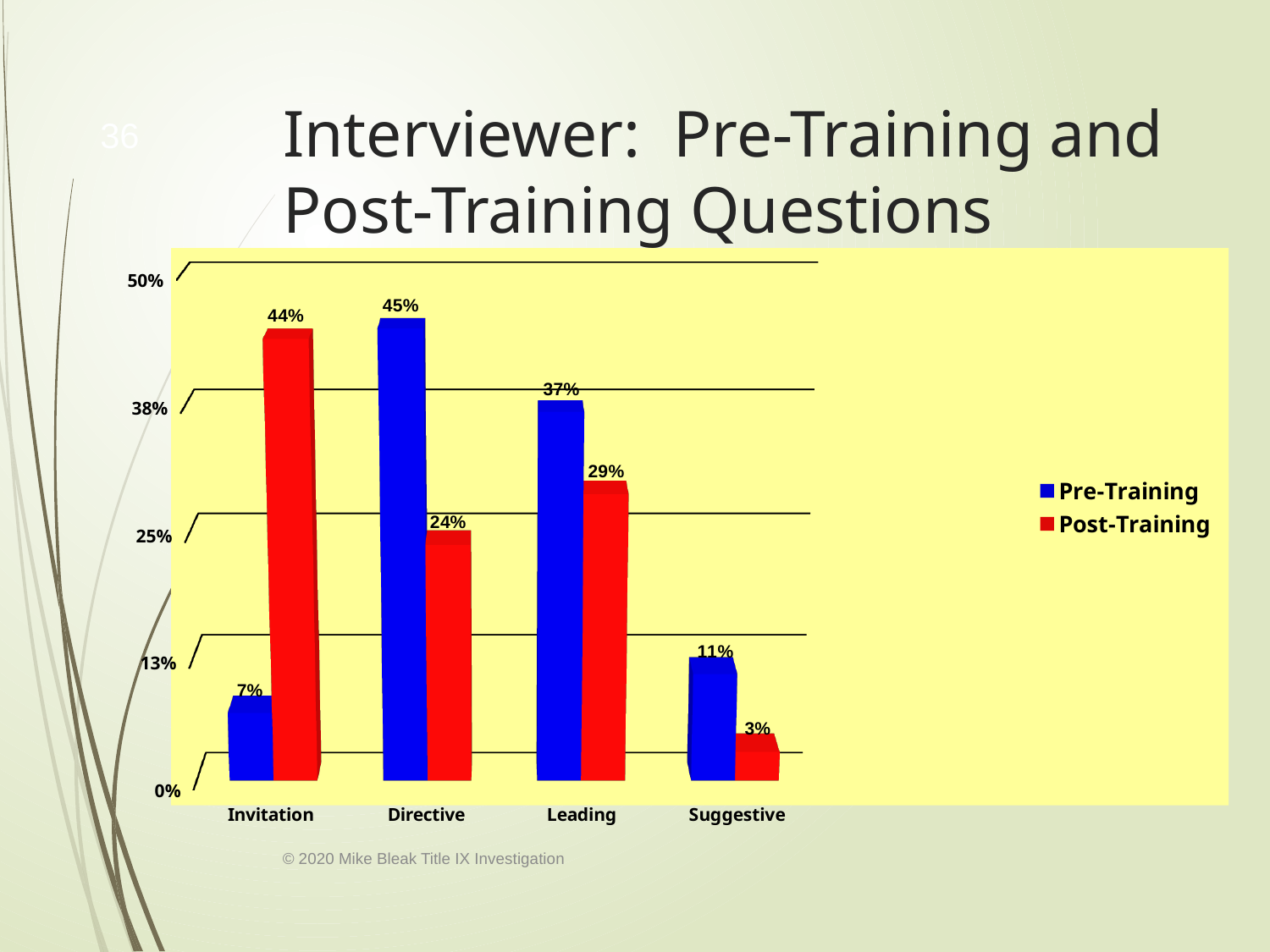
How many series does the legend list? 2 Which category has the highest Pre-Training value? Directive What is the Post-Training value for Suggestive? 3% What is the Post-Training value for Directive? 24% Which category has the lowest Post-Training value? Suggestive What is the difference between the Post-Training and Pre-Training values for Invitation? 37% Which is larger for Directive: the Pre-Training value or the Post-Training value? Pre-Training Which colour represents the Post-Training series? Red What kind of chart is shown on the slide? Bar chart What is the difference between the Pre-Training and Post-Training values for Leading? 8% What is the Pre-Training value for Invitation? 7% How many categories are shown on the x axis? 4